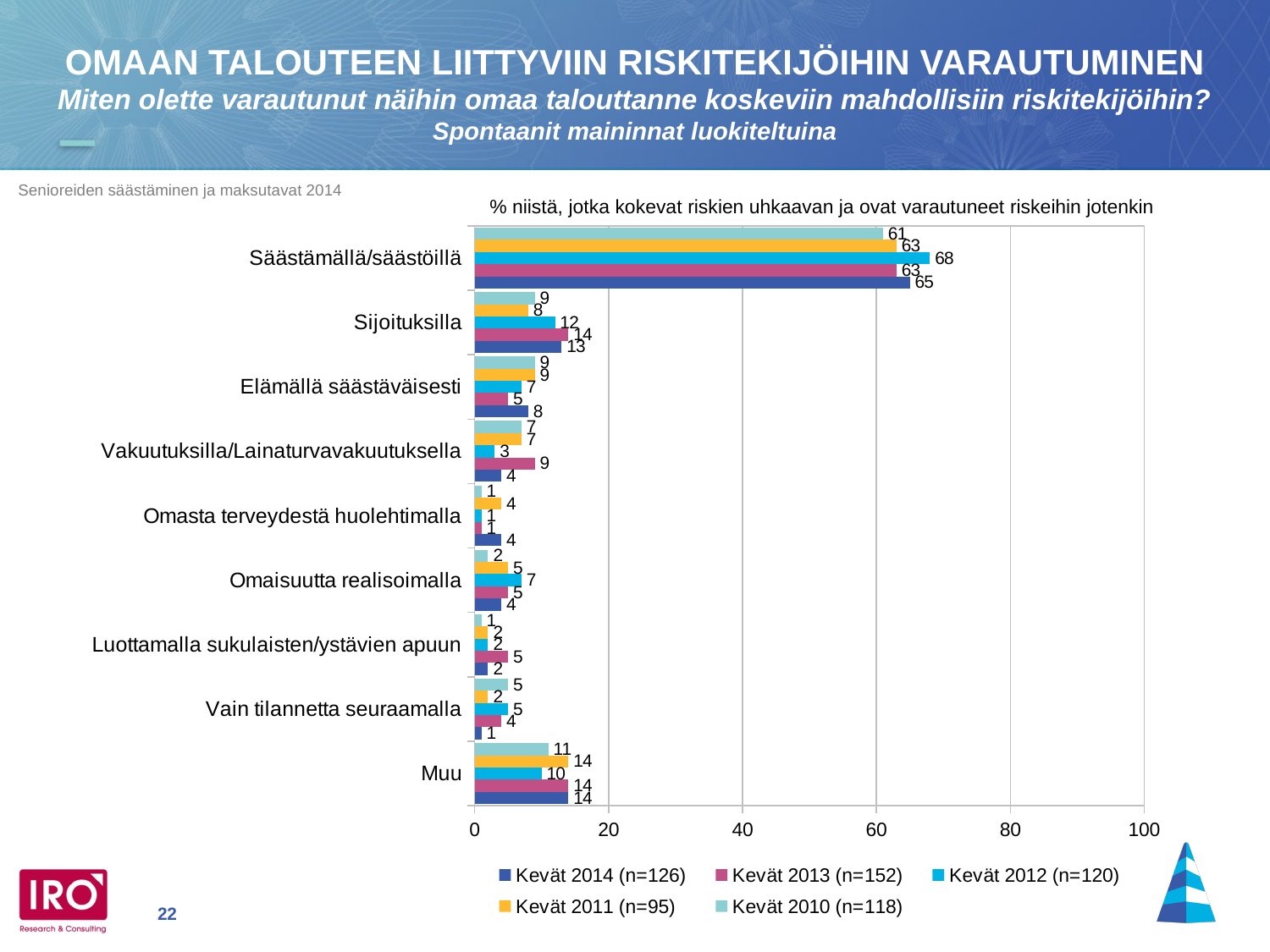
What is the sample size (n) shown in the legend for Kevät 2013? 152 What is the difference between the Kevät 2012 (n=120) and Kevät 2010 (n=118) values for Säästämällä/säästöillä? 7 What is the value for Muu in the Kevät 2012 (n=120) series? 10 How many series does the legend list? 5 Which year series has the highest value for Säästämällä/säästöillä? Kevät 2012 (n=120) What is the value for Säästämällä/säästöillä in the Kevät 2012 (n=120) series? 68 Which is larger for Vakuutuksilla/Lainaturvavakuutuksella: the Kevät 2013 (n=152) value or the Kevät 2014 (n=126) value? Kevät 2013 (n=152) Which category has the highest value in the Kevät 2014 (n=126) series? Säästämällä/säästöillä How many categories are shown on the chart? 9 What kind of chart is shown on the slide? bar chart Is the value for Säästämällä/säästöillä in the Kevät 2014 (n=126) series greater or less than 60? greater What is the value for Sijoituksilla in the Kevät 2013 (n=152) series? 14